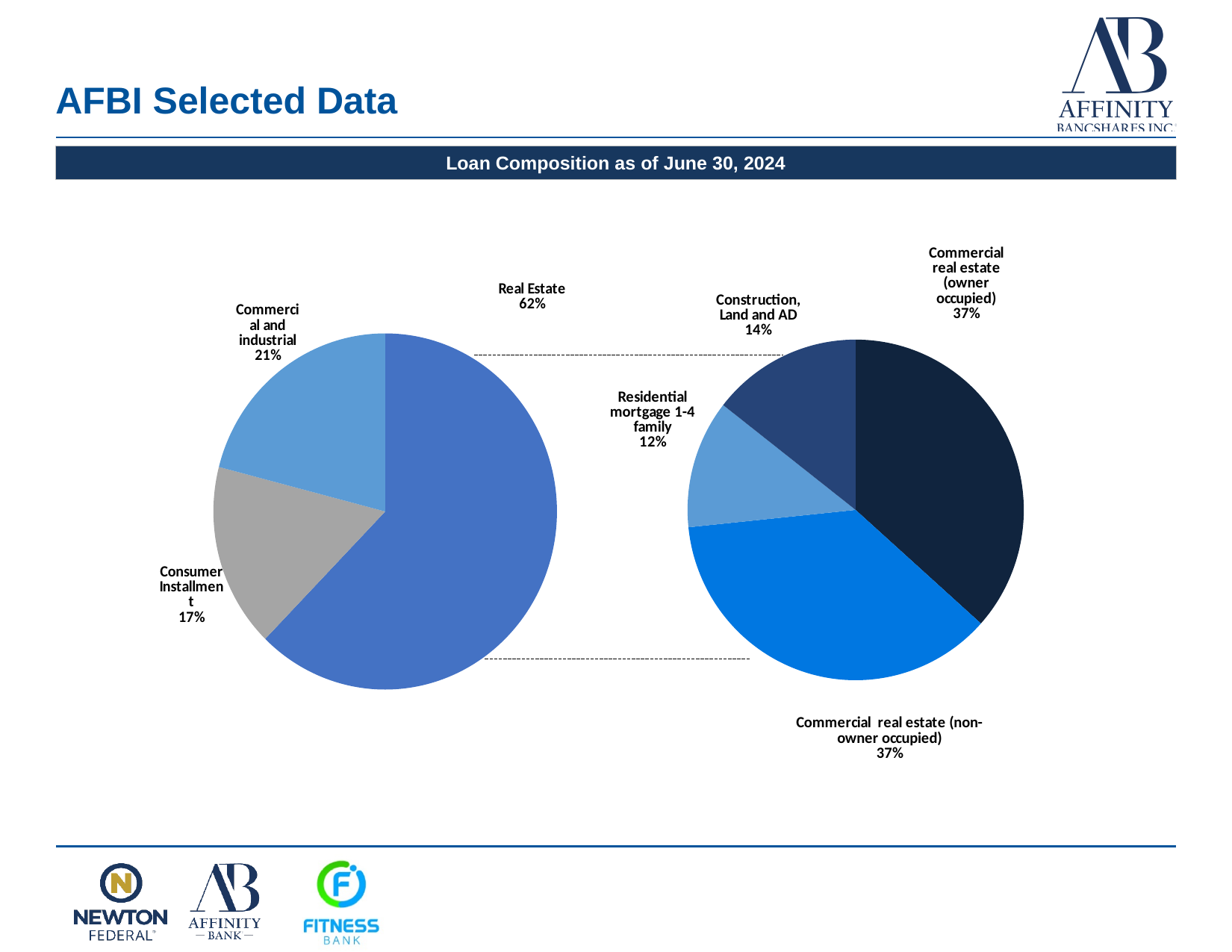
In the right pie chart, what share is Construction, Land and AD? 14% In the right pie chart, what share is Commercial real estate (owner occupied)? 37% In the left pie chart, what is the difference in percentage points between Real Estate and Commercial and industrial? 41 In the left pie chart, which category has the smallest share? Consumer Installment In the left pie chart, what share of loans is Real Estate? 62% How many slices does the right pie chart have? 4 In the right pie chart, which category has the smallest share? Residential mortgage 1-4 family In the left pie chart, what share of loans is Consumer Installment? 17% In the left pie chart, what share of loans is Commercial and industrial? 21% In the right pie chart, what share is Residential mortgage 1-4 family? 12% In the left pie chart, which category has the largest share? Real Estate What type of chart is shown on the slide? Pie chart